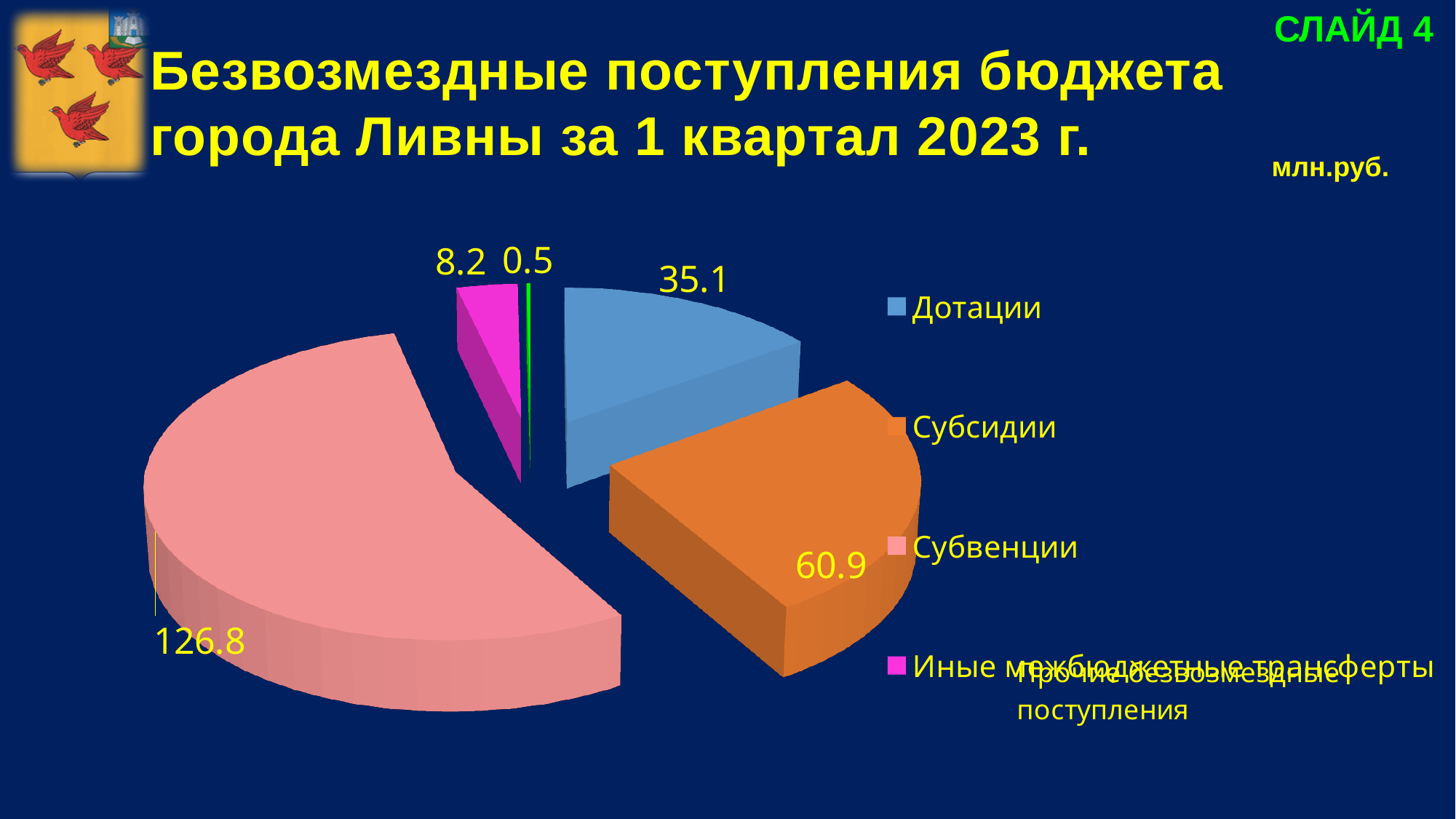
What is the value for Субвенции? 126.8 What unit of measurement is indicated for the chart values? млн.руб. Which category has the largest value in the pie chart? Субвенции What colour is the slice for Субвенции? Pink What is the value for Субсидии? 60.9 What is the value for Иные межбюджетные трансферты? 8.2 What is the value for Дотации? 35.1 What is the difference between the values for Субсидии and Дотации? 25.8 Which is larger, Субсидии or Дотации? Субсидии What type of chart is shown on the slide? Pie chart How many slices does the pie chart have? 5 What is the difference between the values for Субвенции and Субсидии? 65.9